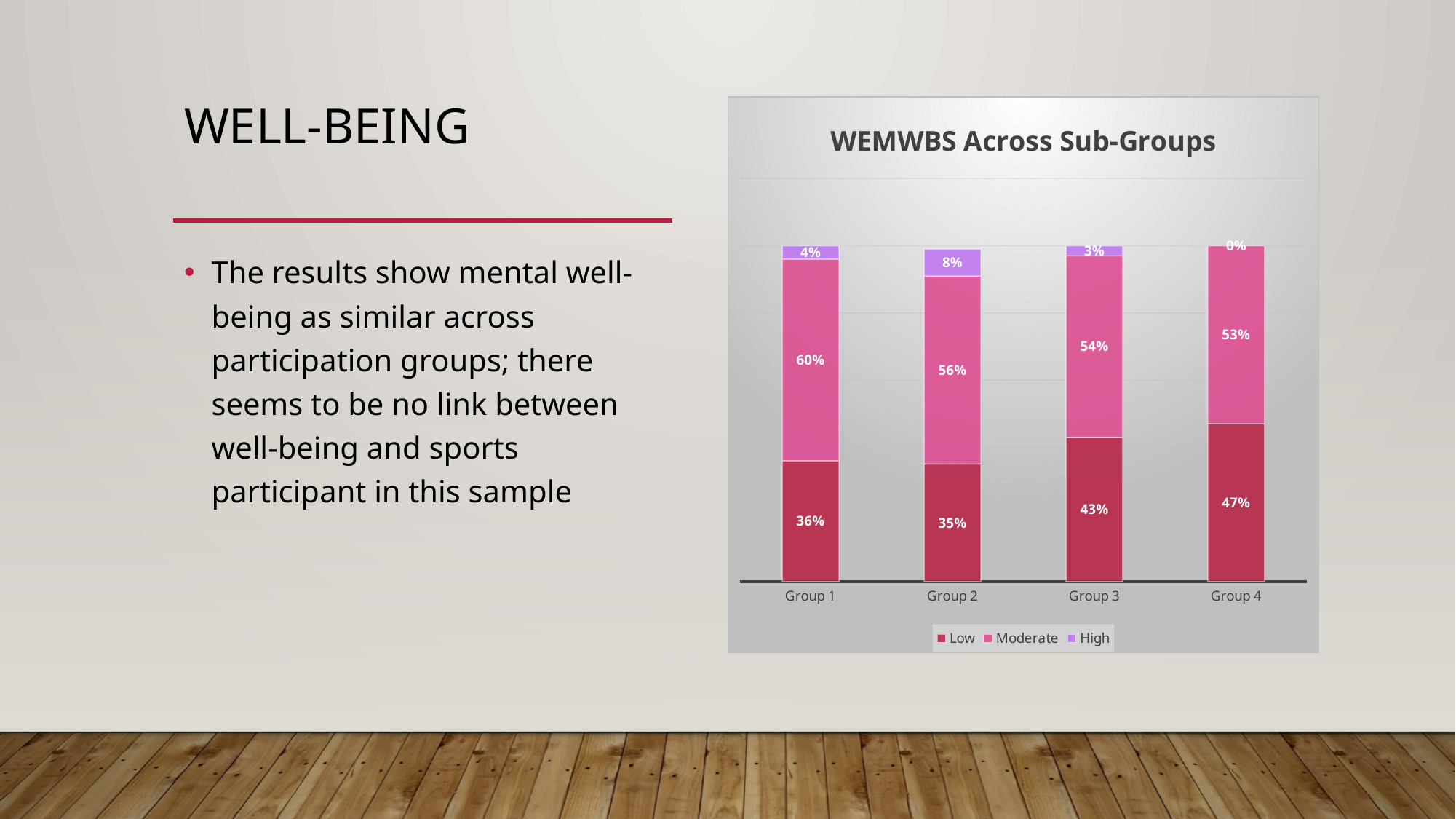
Which is larger, the Moderate value for Group 2 or the Moderate value for Group 3? Group 2 What kind of chart is shown? Stacked bar chart What is the High value for Group 2? 8% What is the Low value for Group 3? 43% Which group has the highest Low value? Group 4 What is the Moderate value for Group 1? 60% What is the High value for Group 4? 0% What is the title of the chart? WEMWBS Across Sub-Groups How many groups are shown on the x axis? 4 Which group has the lowest Moderate value? Group 4 What is the difference between the Low values for Group 4 and Group 2? 12% How many series does the legend list? 3